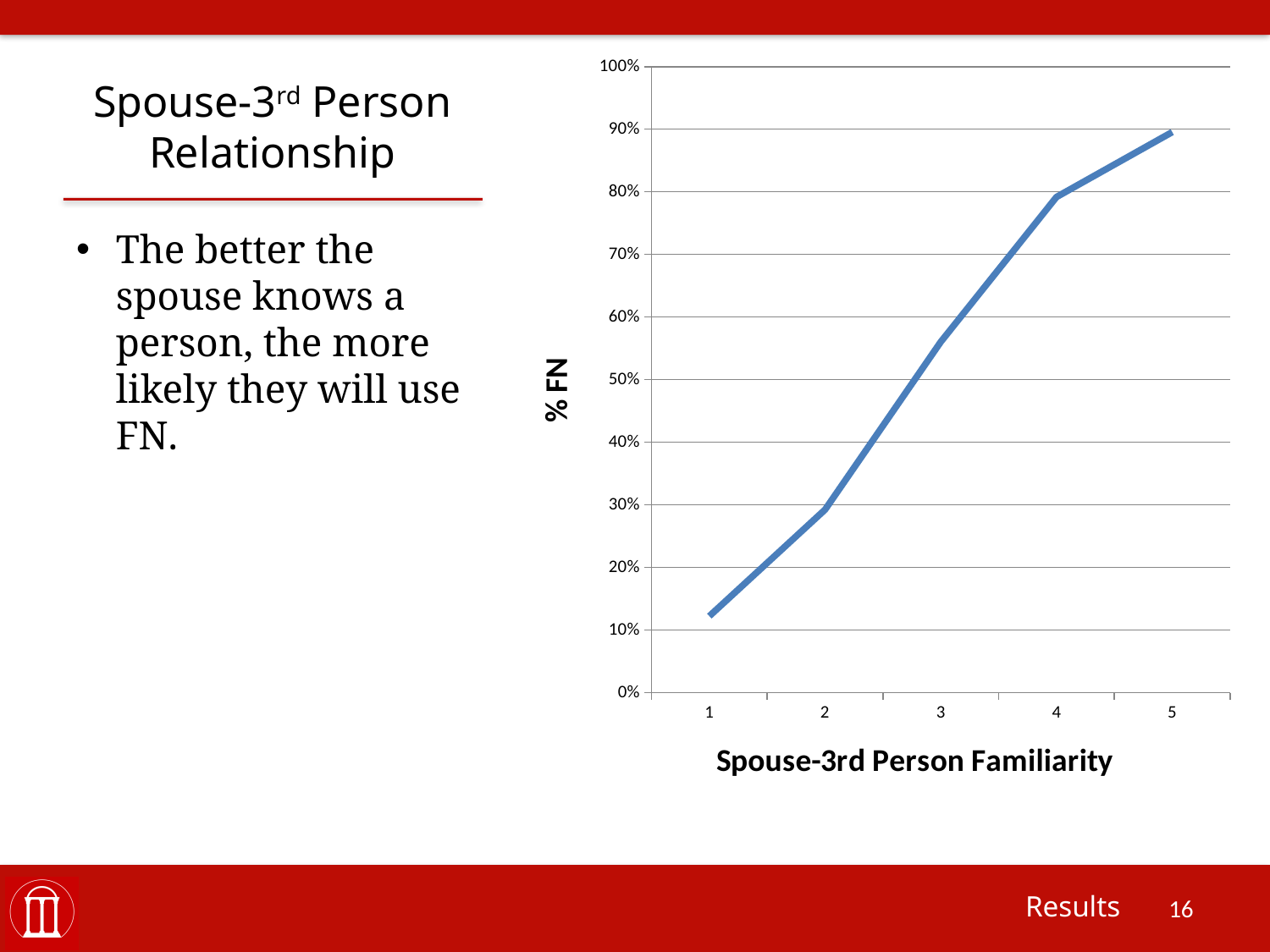
Is the % FN value at familiarity level 5 greater or less than 80%? greater What is the title of the x axis? Spouse-3rd Person Familiarity Is the % FN value at familiarity level 3 greater or less than 50%? greater Do the % FN values rise or fall as Spouse-3rd Person Familiarity increases from 1 to 5? rise Which has a higher % FN: familiarity level 2 or familiarity level 4? 4 What is the title of the y axis? % FN How many points are plotted on the line? 5 What kind of chart is shown on the slide? line chart At which familiarity level is % FN highest? 5 Is the % FN value at familiarity level 1 greater or less than 20%? less At which familiarity level is % FN lowest? 1